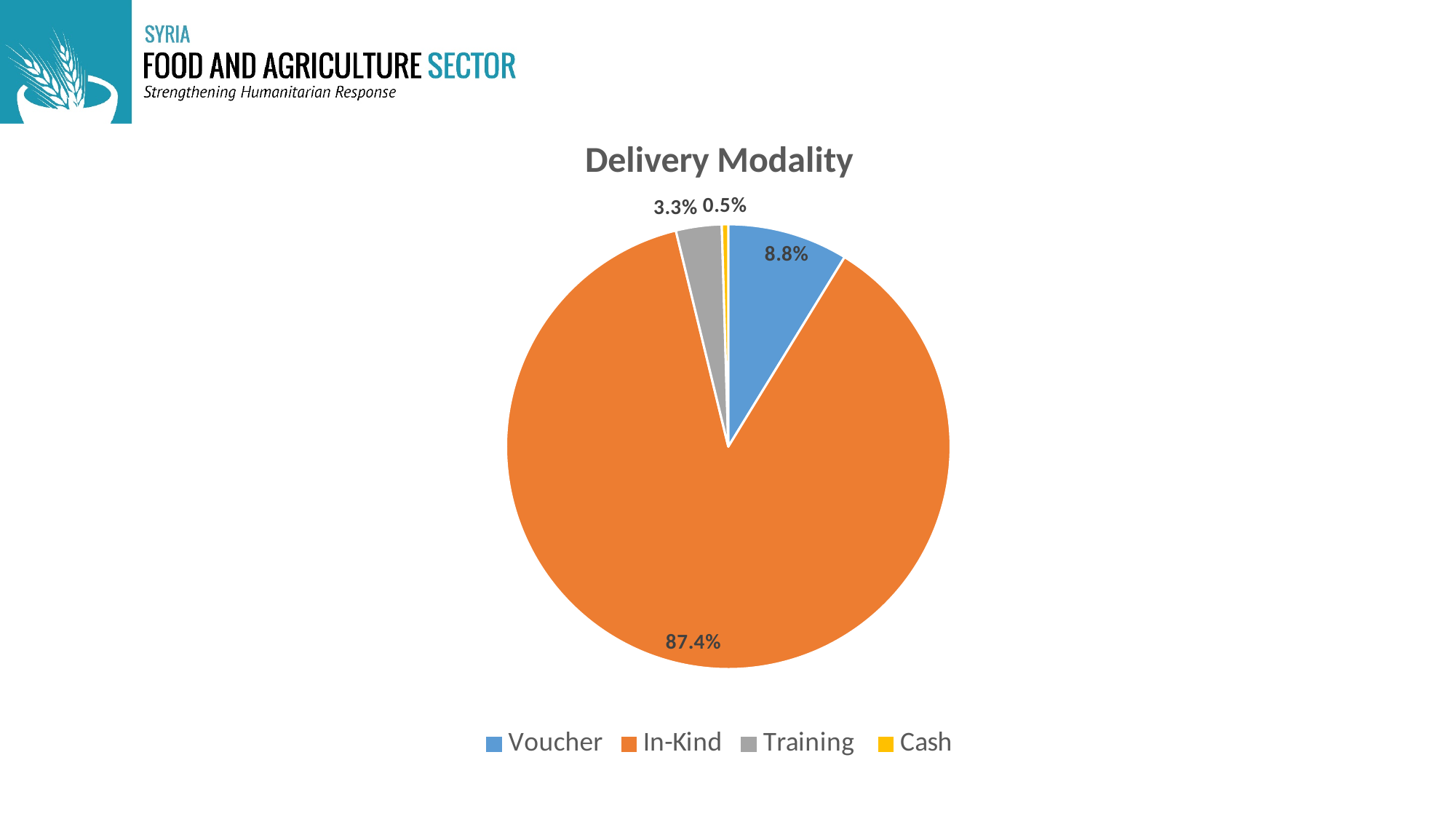
What share of the pie does In-Kind represent? 87.4% What is the difference in percentage points between the In-Kind share and the Voucher share? 78.6 What type of chart is shown on the slide? pie chart Which delivery modality has the smallest share? Cash What share of the pie does Cash represent? 0.5% What share of the pie does Voucher represent? 8.8% What is the title of the chart? Delivery Modality Which is larger, the share for Voucher or the share for Training? Voucher How many categories does the pie chart show? 4 Which colour represents Cash in the legend? yellow Which delivery modality has the largest share? In-Kind